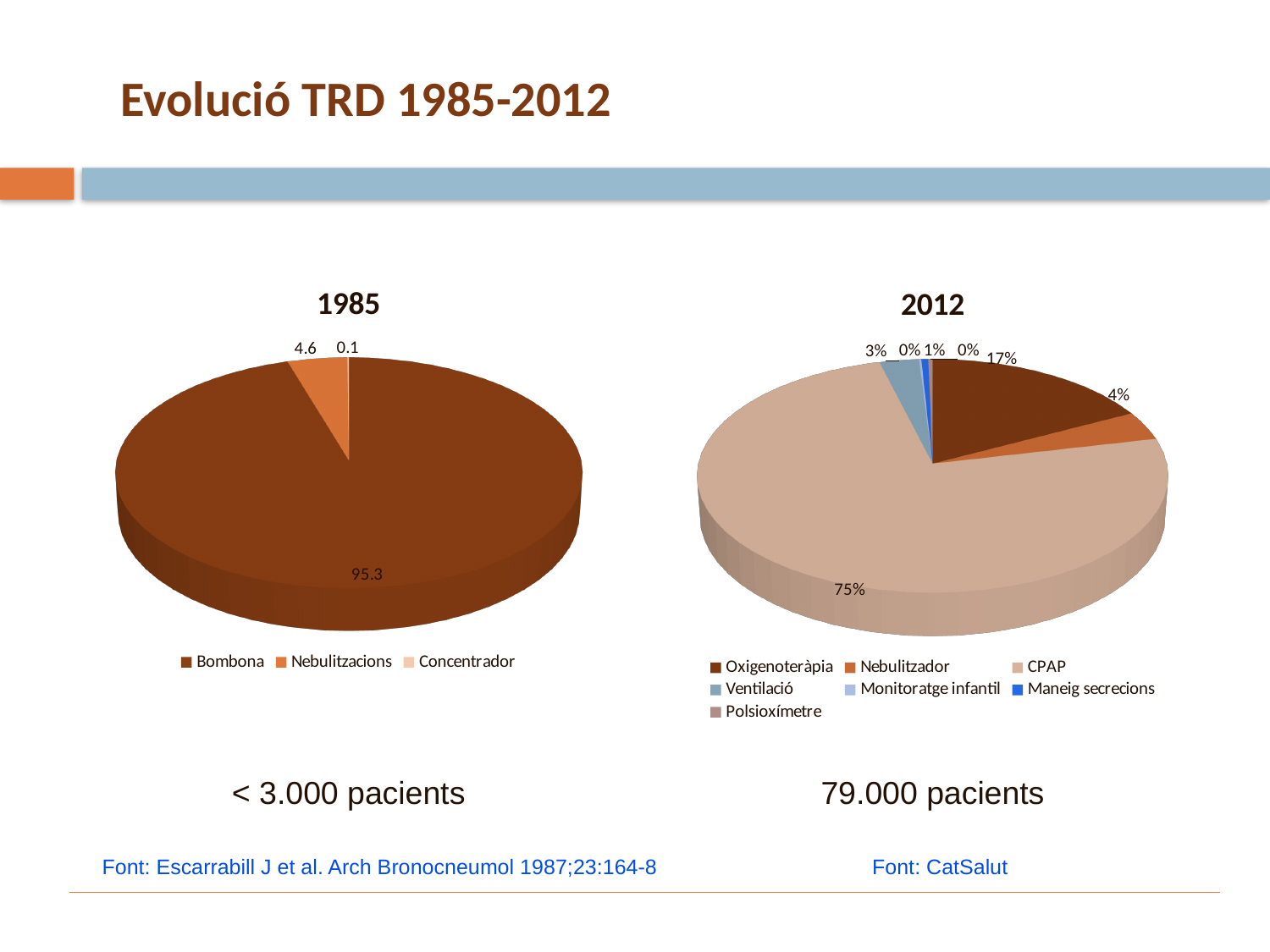
How many categories does the legend of the 1985 chart list? 3 In the 1985 chart, what is the difference between the values for Bombona and Nebulitzacions? 90.7 In the 1985 chart, what is the value for Concentrador? 0.1 In the 1985 chart, which category has the largest slice? Bombona In the 2012 chart, what is the share for Oxigenoteràpia? 17% In the 2012 chart, which is larger, Ventilació or Nebulitzador? Nebulitzador How many categories does the legend of the 2012 chart list? 7 In the 1985 chart, what is the value for Nebulitzacions? 4.6 In the 2012 chart, what is the share for CPAP? 75% In the 2012 chart, which category has the largest slice? CPAP In the 1985 chart, what is the value for Bombona? 95.3 What kind of chart is the 1985 chart? pie chart